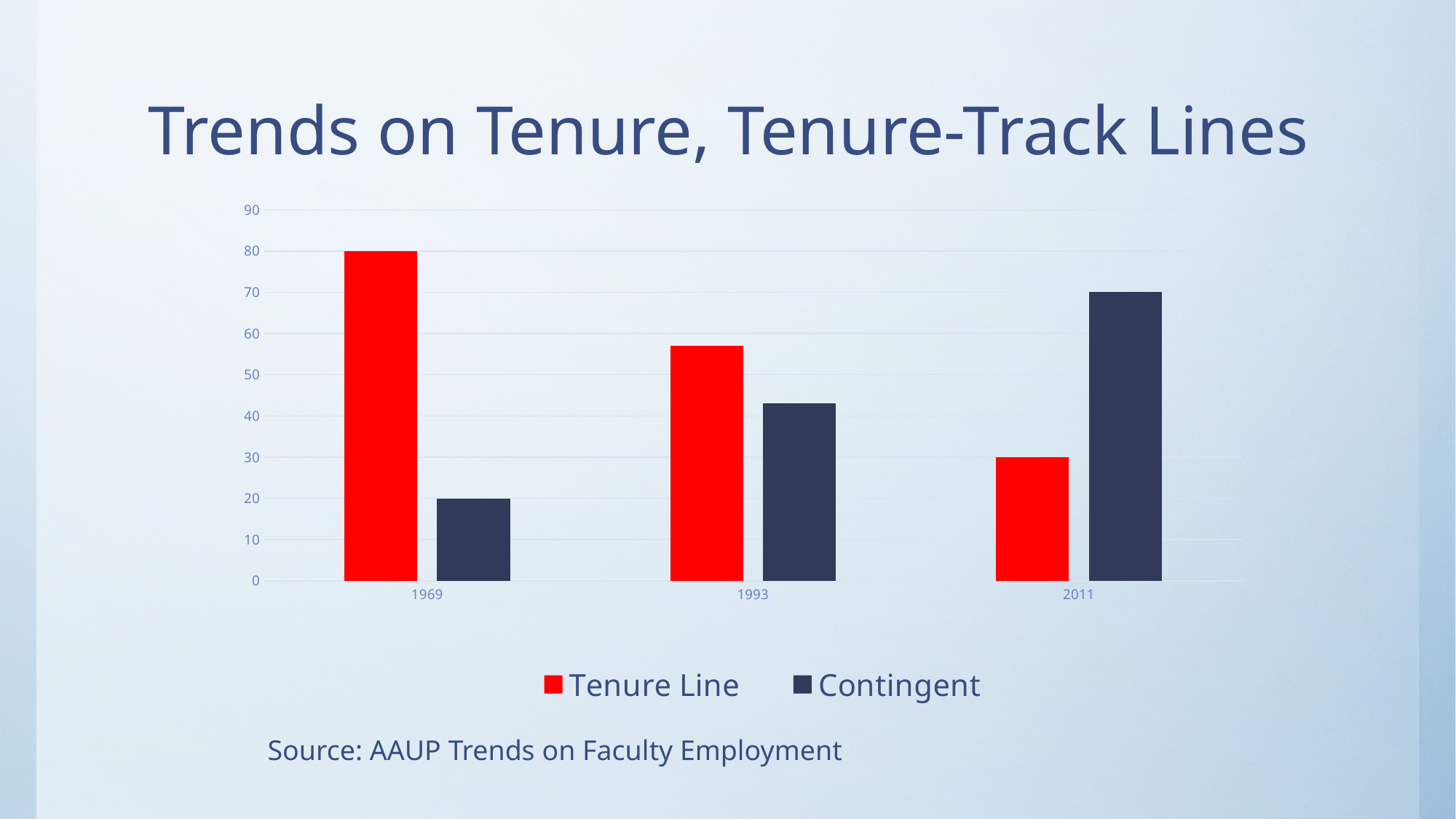
What is the Contingent value for 2011? 70 What is the difference between the Tenure Line and Contingent values in 1969? 60 Does the Tenure Line series rise or fall from 1969 to 2011? fall What is the Contingent value for 1969? 20 Which series has the larger value in 2011, Tenure Line or Contingent? Contingent What is the title of the chart? Trends on Tenure, Tenure-Track Lines What is the Tenure Line value for 1969? 80 How many years are shown on the x axis? 3 What is the Tenure Line value for 2011? 30 How many series does the legend list? 2 Is the Tenure Line value for 1993 greater or less than 50? greater What type of chart is shown on the slide? bar chart